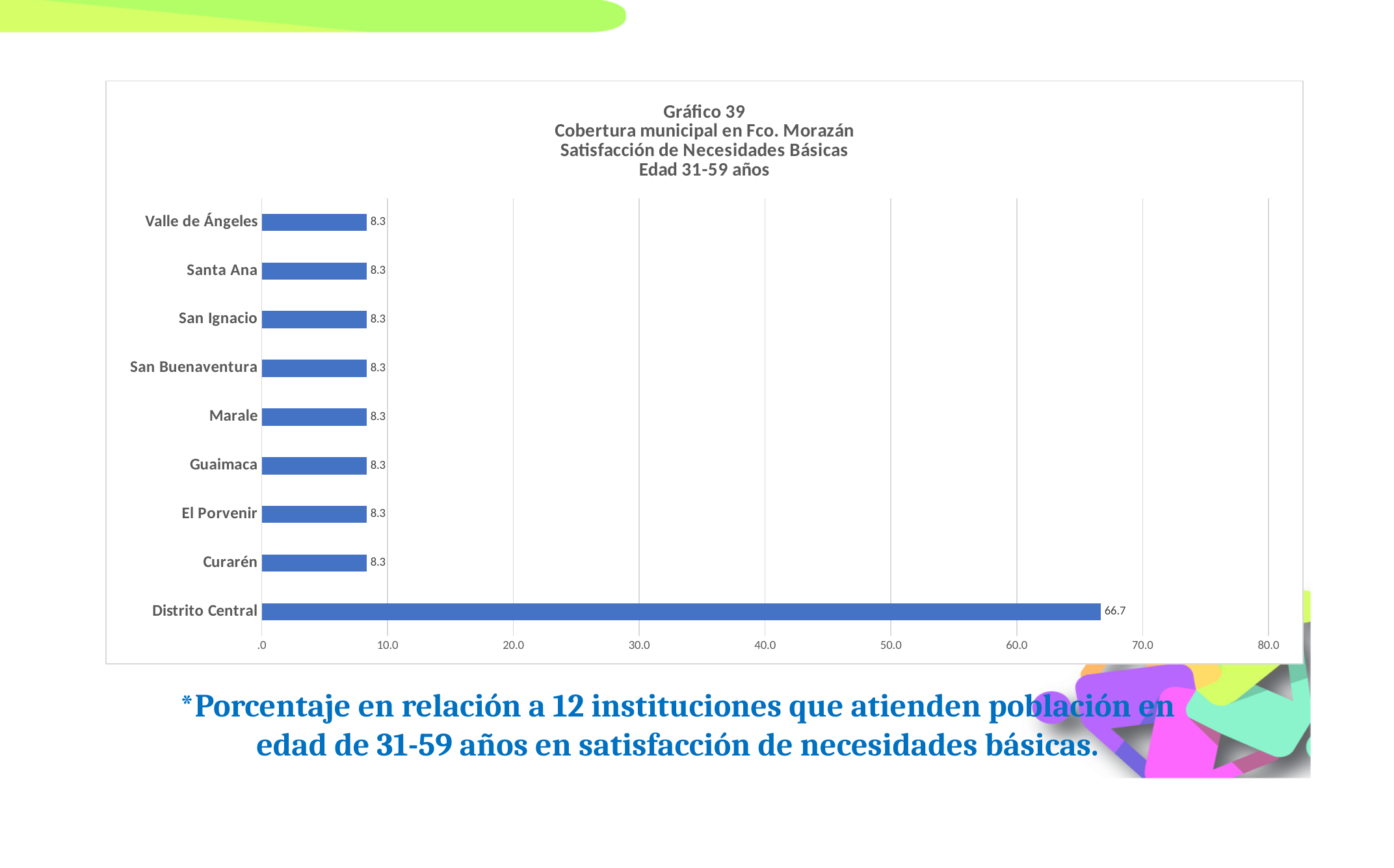
What is the value for Distrito Central? 66.7 What is the value for Guaimaca? 8.3 Is the value for Distrito Central greater or less than 60.0? greater What is the highest value shown on the horizontal axis? 80.0 What is the difference between the values for Distrito Central and Curarén? 58.4 What kind of chart is shown on the slide? bar chart Which is larger, the value for Distrito Central or the value for Santa Ana? Distrito Central What is the value for Valle de Ángeles? 8.3 Is the value for Marale greater or less than 10.0? less Which municipality has the highest value? Distrito Central What age range is named in the chart title? 31-59 años How many municipalities are shown in the chart? 9